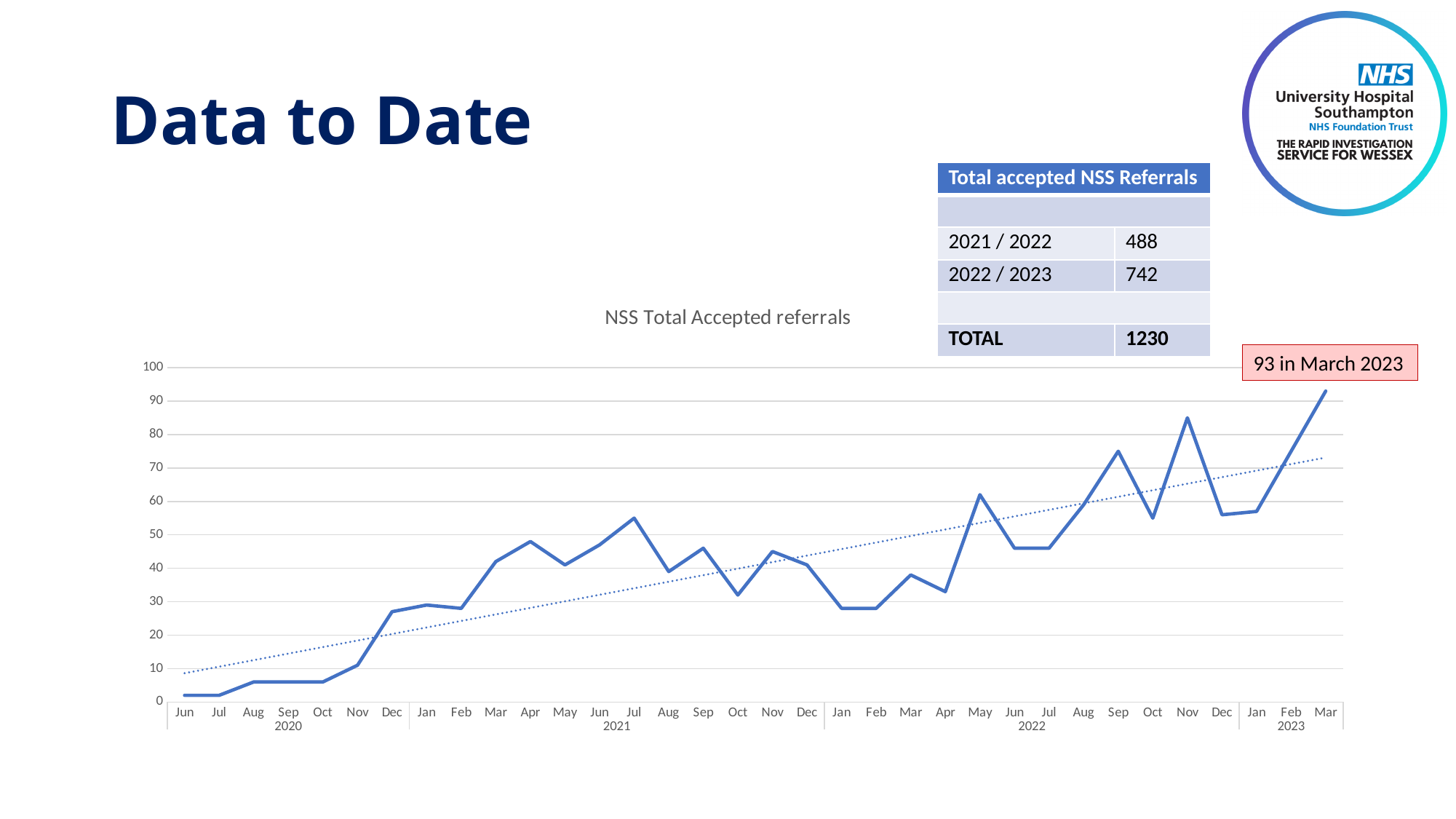
Is the value for September 2022 greater or less than 70? greater Is the value for October 2021 greater or less than 40? less Is the value for June 2020 greater or less than 10? less What is the value for March 2023 in the NSS Total Accepted referrals chart? 93 Which month has the highest value in the NSS Total Accepted referrals chart? March 2023 What kind of chart is shown on the slide? line chart What is the title of the chart? NSS Total Accepted referrals How many monthly data points are plotted in the chart? 34 Which is larger, the value for July 2021 or the value for April 2021? July 2021 Overall, do the values rise or fall from June 2020 to March 2023? rise Which is larger, the value for November 2022 or the value for September 2022? November 2022